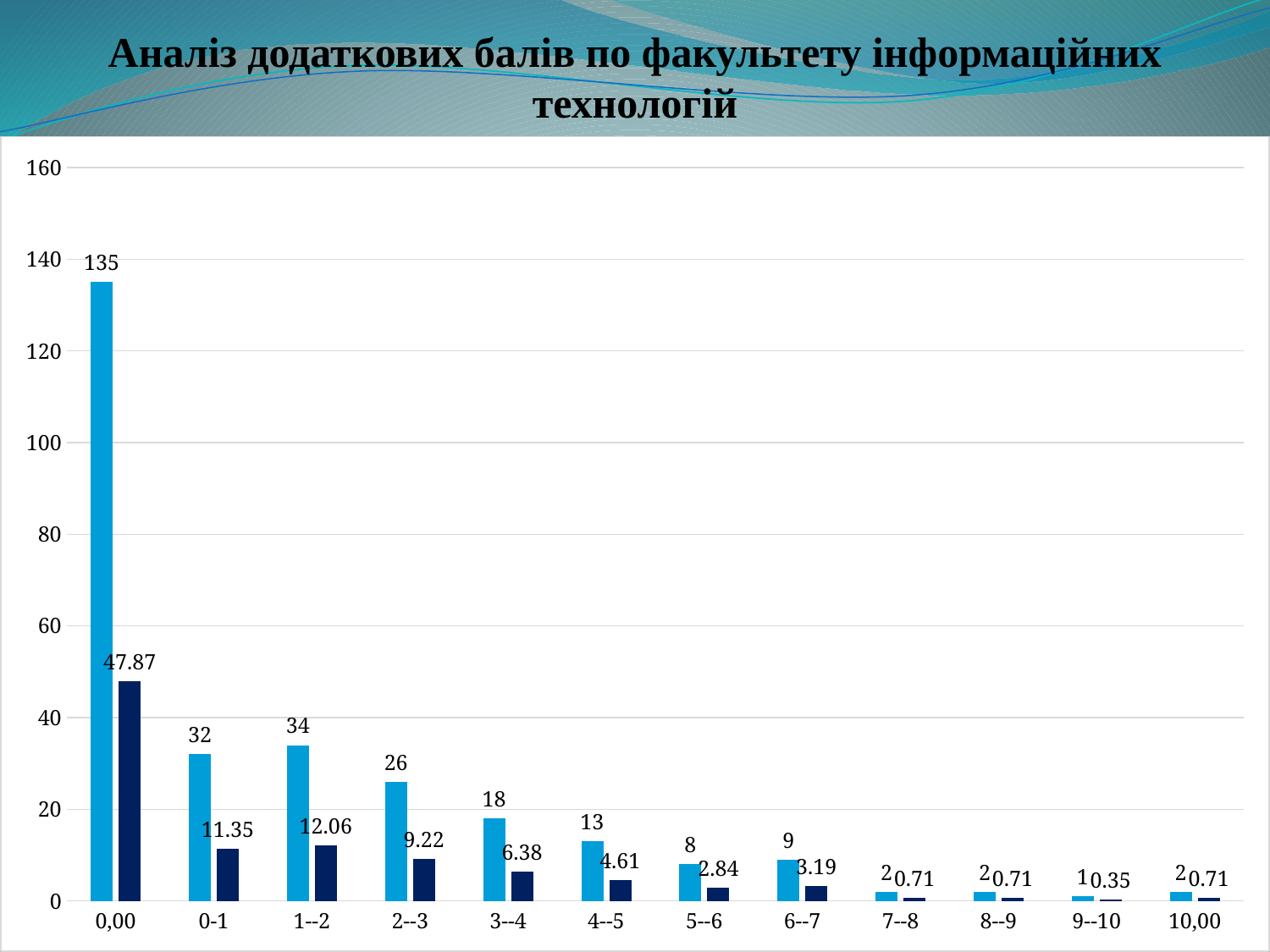
What is the value of the light blue bar for the category 0,00? 135 Which is larger, the light blue value for 5--6 or for 6--7? 6--7 What is the value of the dark blue bar for the category 0,00? 47.87 Which category has the highest light blue bar? 0,00 What kind of chart is shown on the slide? Bar chart What is the value of the dark blue bar for the category 4--5? 4.61 What is the difference between the light blue values for 1--2 and 0-1? 2 How many categories are shown on the x axis? 12 What is the value of the light blue bar for the category 2--3? 26 What is the title of the chart on the slide? Аналіз додаткових балів по факультету інформаційних технологій Is the light blue value for 0,00 greater or less than 120? greater Which category has the lowest light blue bar? 9--10